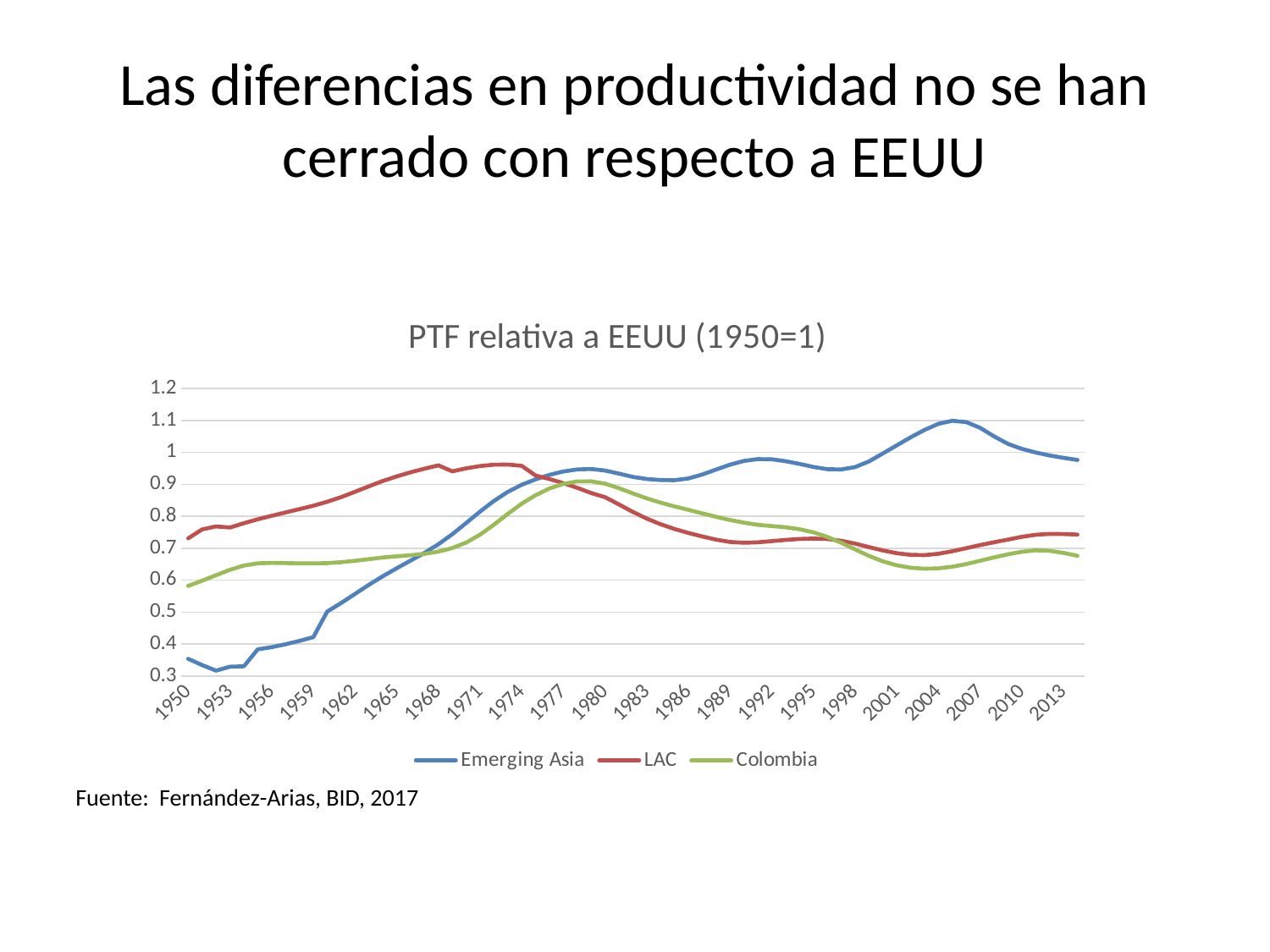
Is the value for Emerging Asia in 1950 greater or less than 0.4? less Is the value for Emerging Asia in 2007 greater or less than 1? greater Which series has the highest value in 2007? Emerging Asia What kind of chart is shown on the slide? line chart In 1950, which is larger, the value for LAC or the value for Emerging Asia? LAC Which colour is used for the Emerging Asia line? blue What is the title of the chart? PTF relativa a EEUU (1950=1) Is the value for LAC in 1968 greater or less than 0.9? greater Does the Emerging Asia line rise or fall between 1950 and 1977? rise How many series does the legend list? 3 Which series has the lowest value in 1950? Emerging Asia